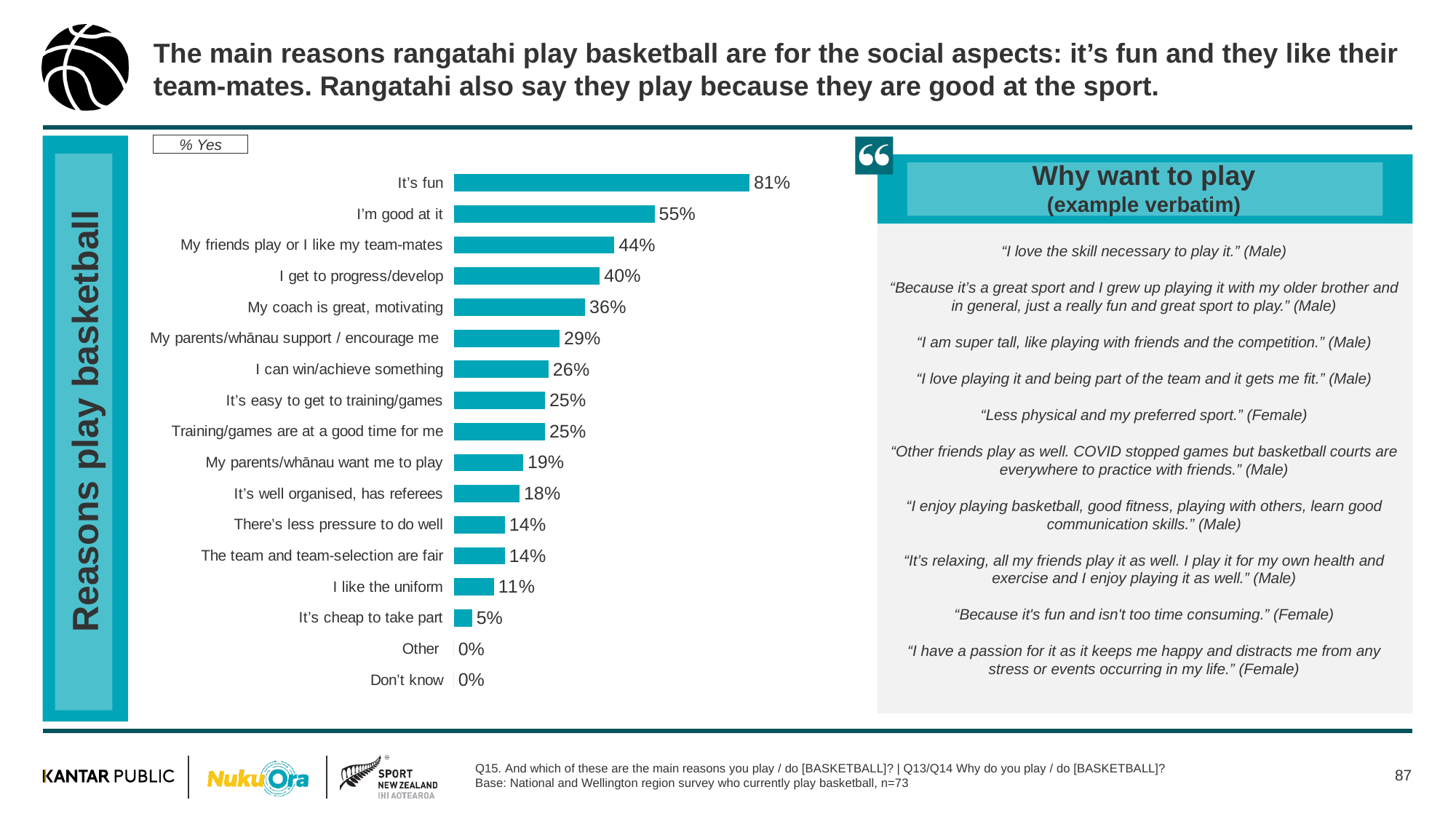
What is the difference between "I can win/achieve something" and "It's well organised, has referees"? 8 percentage points What is the value for "I like the uniform"? 11% Which reason for playing basketball has the highest percentage? It's fun What is the value for "I'm good at it"? 55% Which reason has the lowest non-zero percentage? It's cheap to take part What percentage of rangatahi say they play basketball because it's fun? 81% What is the difference between "It's fun" and "I'm good at it"? 26 percentage points What unit label is shown above the bar chart? % Yes How many categories (reasons) are shown in the bar chart? 17 What type of chart is used to show the reasons rangatahi play basketball? Bar chart What percentage say "My coach is great, motivating" is a reason they play basketball? 36% Which is larger: "I get to progress/develop" or "My parents/whānau support / encourage me"? I get to progress/develop